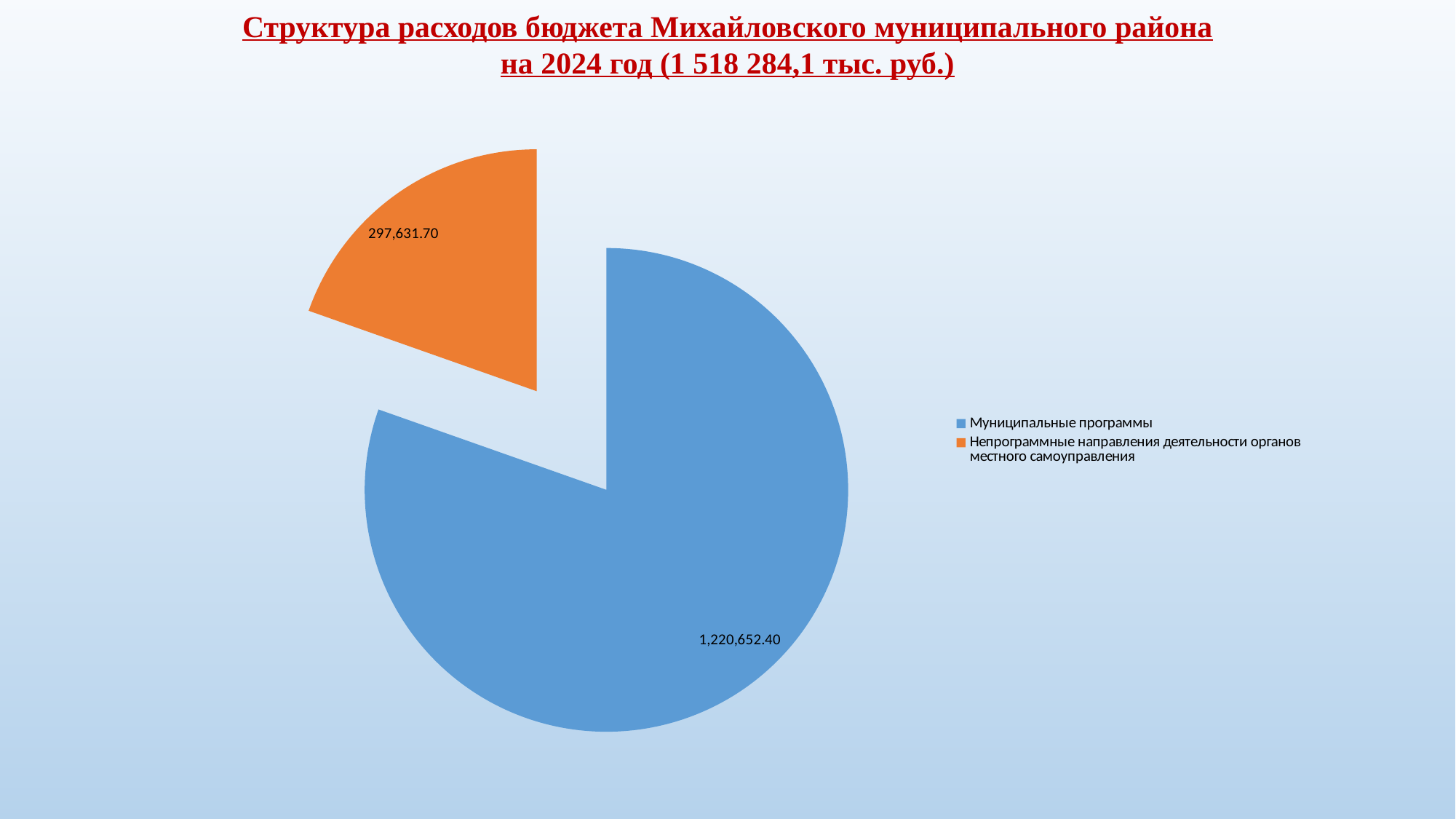
What share of the pie does Муниципальные программы represent, to one decimal place? 80.4% Which category has the largest slice of the pie? Муниципальные программы What is the value for Непрограммные направления деятельности органов местного самоуправления? 297,631.70 What is the value for Муниципальные программы? 1,220,652.40 How many slices does the pie chart have? 2 What colour is the slice for Непрограммные направления деятельности органов местного самоуправления? Orange Which is larger: the value for Муниципальные программы or the value for Непрограммные направления деятельности органов местного самоуправления? Муниципальные программы Which category has the smallest slice of the pie? Непрограммные направления деятельности органов местного самоуправления What is the total of the two slices in the pie chart? 1,518,284.10 What is the difference between the value for Муниципальные программы and the value for Непрограммные направления деятельности органов местного самоуправления? 923,020.70 What kind of chart is shown on the slide? Pie chart How many entries does the legend list? 2